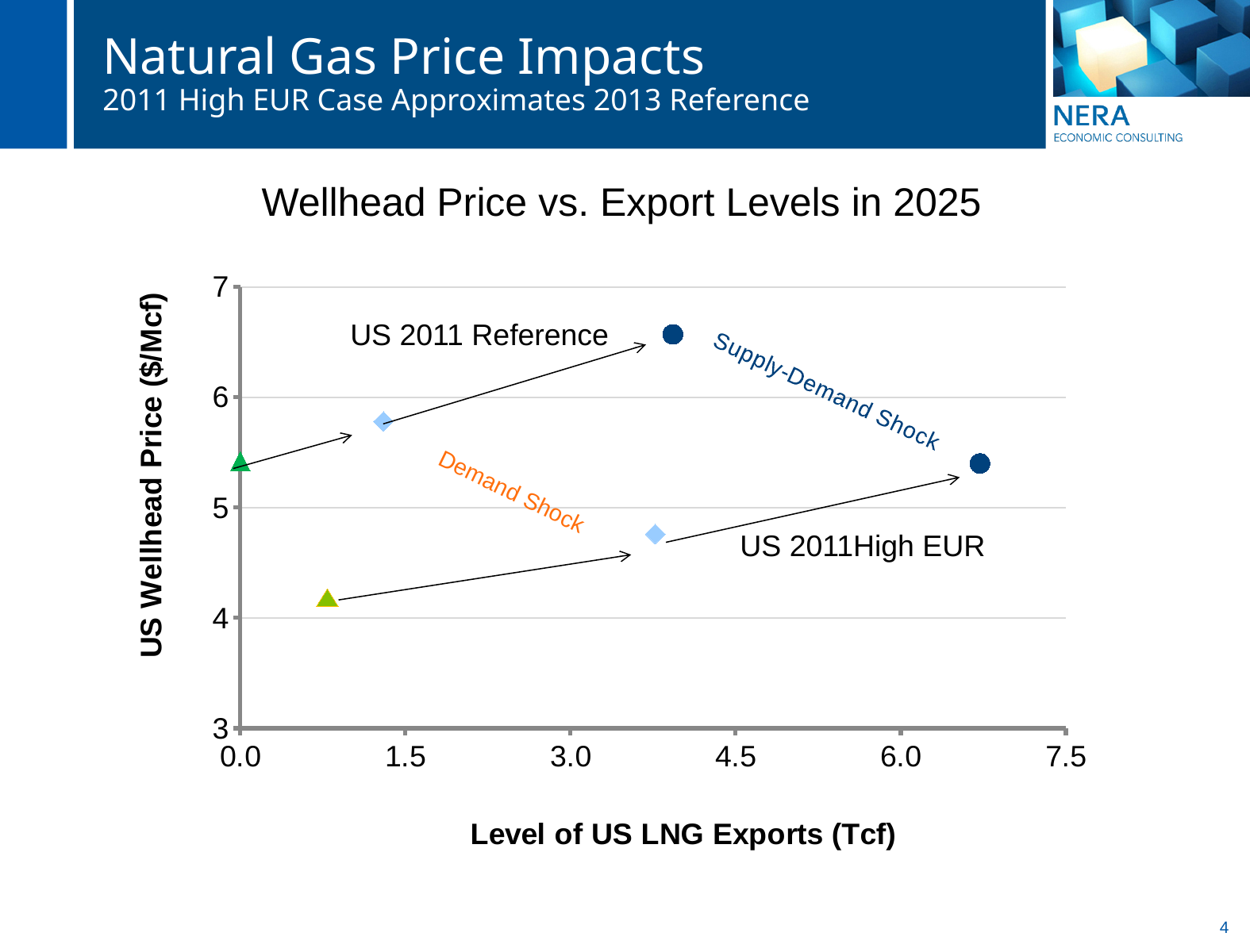
Is the wellhead price of the starting point (green triangle) on the US 2011 High EUR path greater or less than 5 $/Mcf? less Is the wellhead price of the Demand Shock point (light diamond) on the US 2011 Reference path greater or less than 5 $/Mcf? greater Is the wellhead price of the Demand Shock point (light diamond) on the US 2011 High EUR path greater or less than 5 $/Mcf? less Which point on the chart has the highest wellhead price? the Supply-Demand Shock point on the US 2011 Reference path What kind of chart is shown on the slide? scatter chart What is the title of the chart? Wellhead Price vs. Export Levels in 2025 What is the label of the x axis? Level of US LNG Exports (Tcf) Which path has the higher wellhead price at its Supply-Demand Shock point, US 2011 Reference or US 2011 High EUR? US 2011 Reference How many data points are plotted on the chart? 6 Along the US 2011 High EUR path, does the wellhead price rise or fall as the level of LNG exports increases? rise